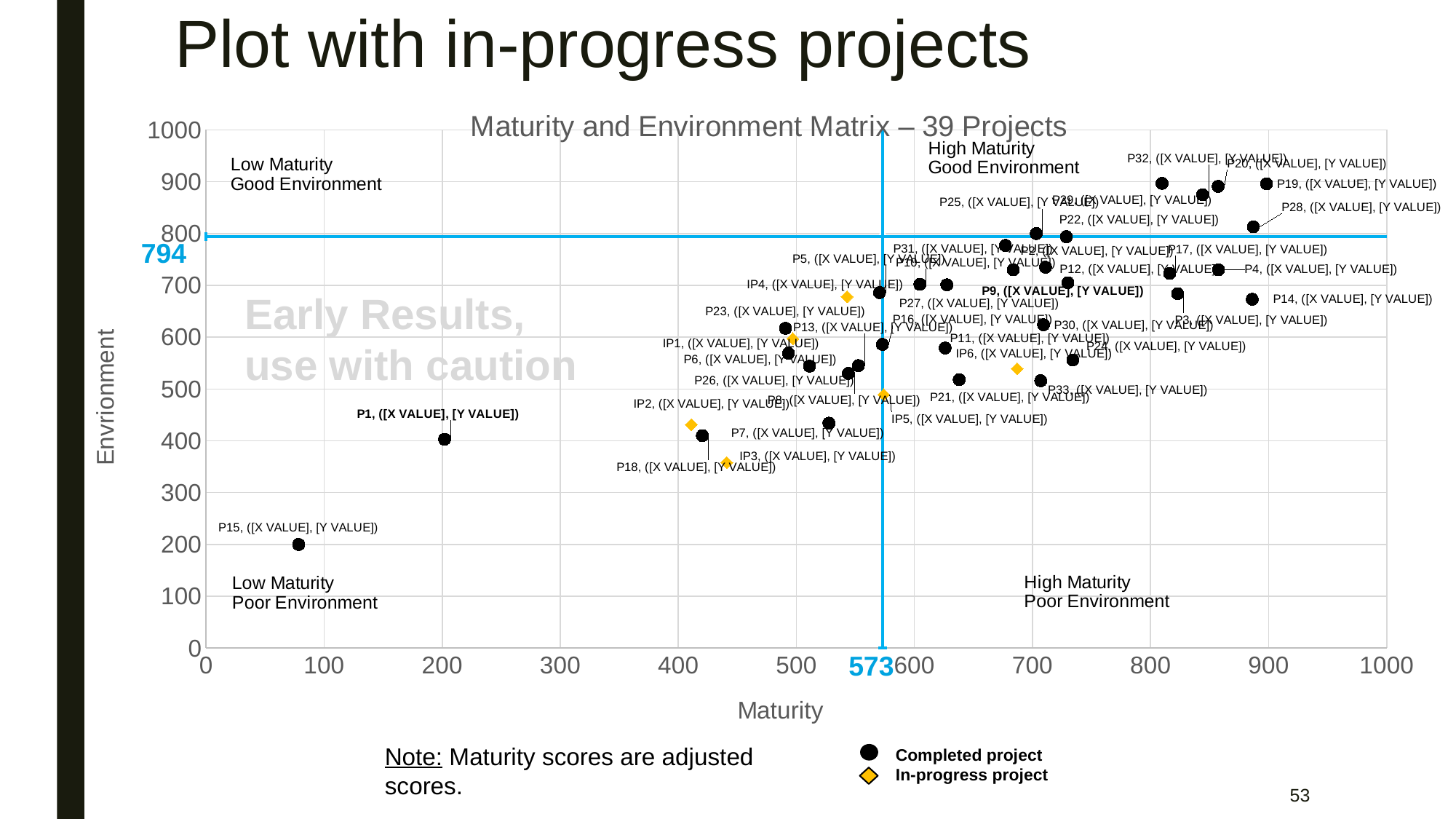
How many in-progress project points are plotted on the chart? 6 Is the Environment value for P19 greater or less than 800? greater How many series does the chart legend list? 2 Is the Maturity value for P1 greater or less than 300? less Which project has the lowest Maturity score? P15 Is the Environment value for P15 greater or less than 300? less Which project has the lowest Environment score? P15 What is the title of the chart? Maturity and Environment Matrix – 39 Projects What kind of chart is shown on the slide? Scatter chart What value is marked on the horizontal reference line on the Environment axis? 794 What value is marked on the vertical reference line on the Maturity axis? 573 Which project has the higher Environment score, P14 or P18? P14